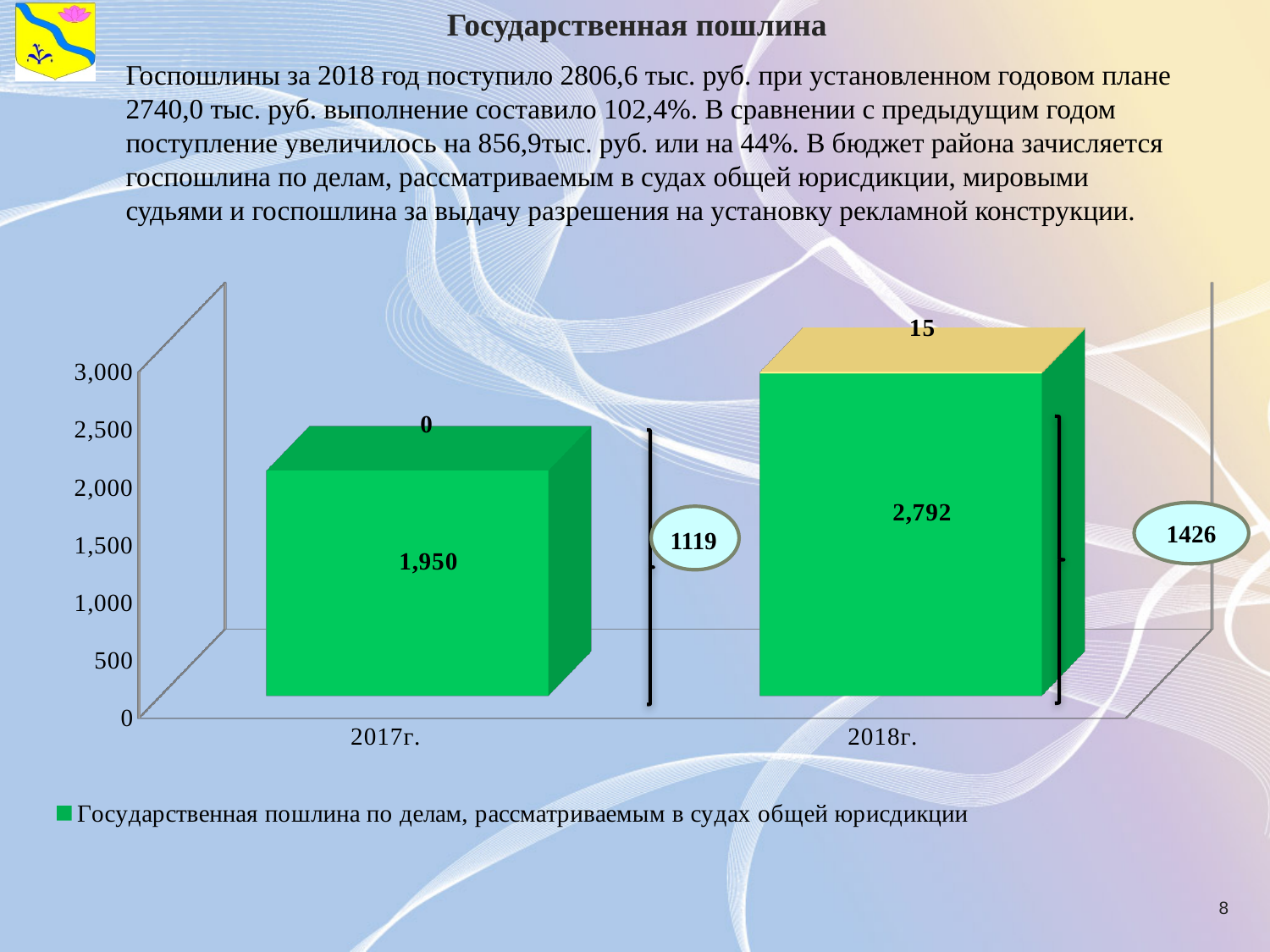
How many series does the legend list? 1 What is the total of the stacked bar for 2018г. (2,792 plus 15)? 2,807 What value is labelled on the yellow top segment of the 2018г. bar? 15 What is the value of the green series (Государственная пошлина по делам, рассматриваемым в судах общей юрисдикции) for 2018г.? 2,792 Which year has the lower value for the green series? 2017г. Is the green series value for 2017г. greater or less than 2,000? less What value is labelled on top of the 2017г. bar? 0 What is the value of the green series (Государственная пошлина по делам, рассматриваемым в судах общей юрисдикции) for 2017г.? 1,950 What kind of chart is shown on the slide? bar chart Which year has the higher value for the green series? 2018г. How many categories (years) are shown on the x axis? 2 By how much does the green series value for 2018г. exceed that for 2017г.? 842